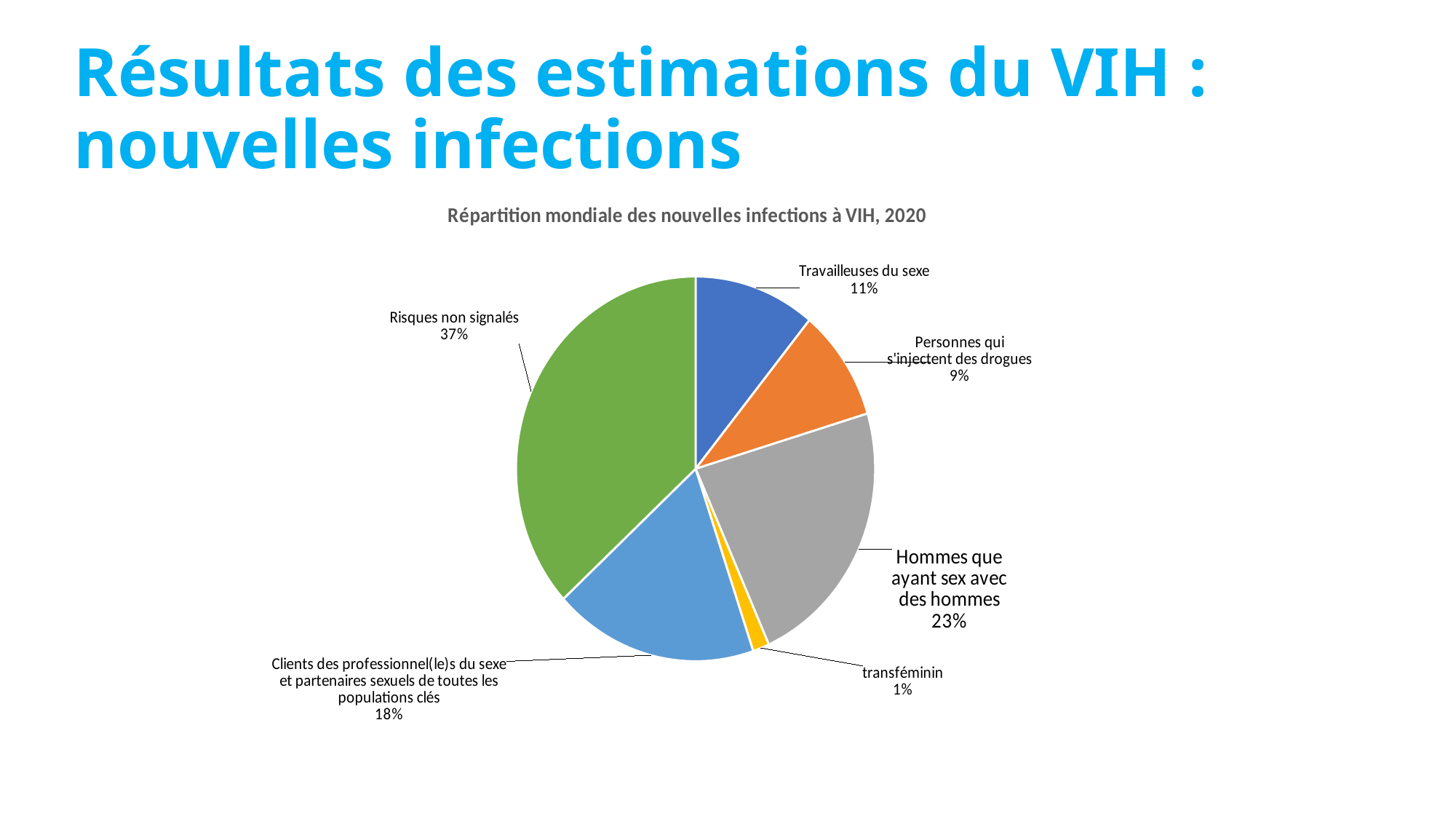
What share is shown for 'transféminin'? 1% Which category has the largest slice of the pie? Risques non signalés What share is shown for 'Hommes que ayant sex avec des hommes'? 23% How many categories are shown in the pie chart? 6 What is the chart's title? Répartition mondiale des nouvelles infections à VIH, 2020 Which is larger: the share for 'Travailleuses du sexe' or for 'Personnes qui s'injectent des drogues'? Travailleuses du sexe Which category has the smallest slice of the pie? transféminin What share of new HIV infections is attributed to 'Risques non signalés'? 37% What share is shown for 'Travailleuses du sexe'? 11% What is the difference in percentage points between 'Risques non signalés' and 'Hommes que ayant sex avec des hommes'? 14 percentage points What share is shown for 'Personnes qui s'injectent des drogues'? 9% What kind of chart is shown on the slide? pie chart